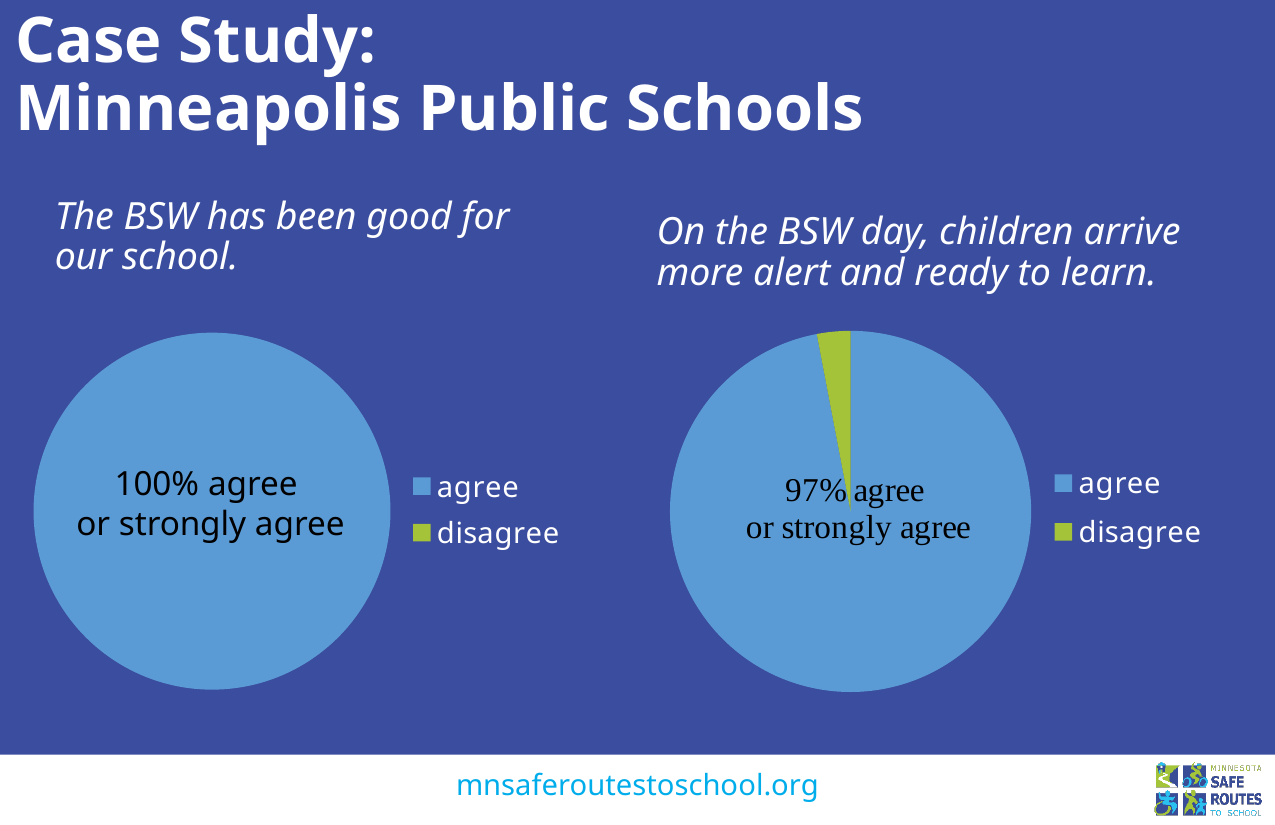
What are the two legend entries shown next to the left pie chart? agree, disagree How many pie charts are shown on the slide? 2 In the right pie chart ("On the BSW day, children arrive more alert and ready to learn"), what percentage agree or strongly agree? 97% agree or strongly agree What share of the right pie chart ("children arrive more alert and ready to learn") is the disagree slice? 3% In the right pie chart, which category has the smallest slice? disagree In the left pie chart ("The BSW has been good for our school"), what percentage agree or strongly agree? 100% agree or strongly agree What colour represents "disagree" in the pie chart legends? green Which pie chart shows a higher agree percentage, the left one ("good for our school") or the right one ("more alert and ready to learn")? the left one What type of chart is used on the left side of the slide, under "The BSW has been good for our school"? pie chart What is the difference between the agree percentage in the left pie chart and the agree percentage in the right pie chart? 3% In the right pie chart, which slice is larger, agree or disagree? agree How many entries does the legend of the right pie chart list? 2